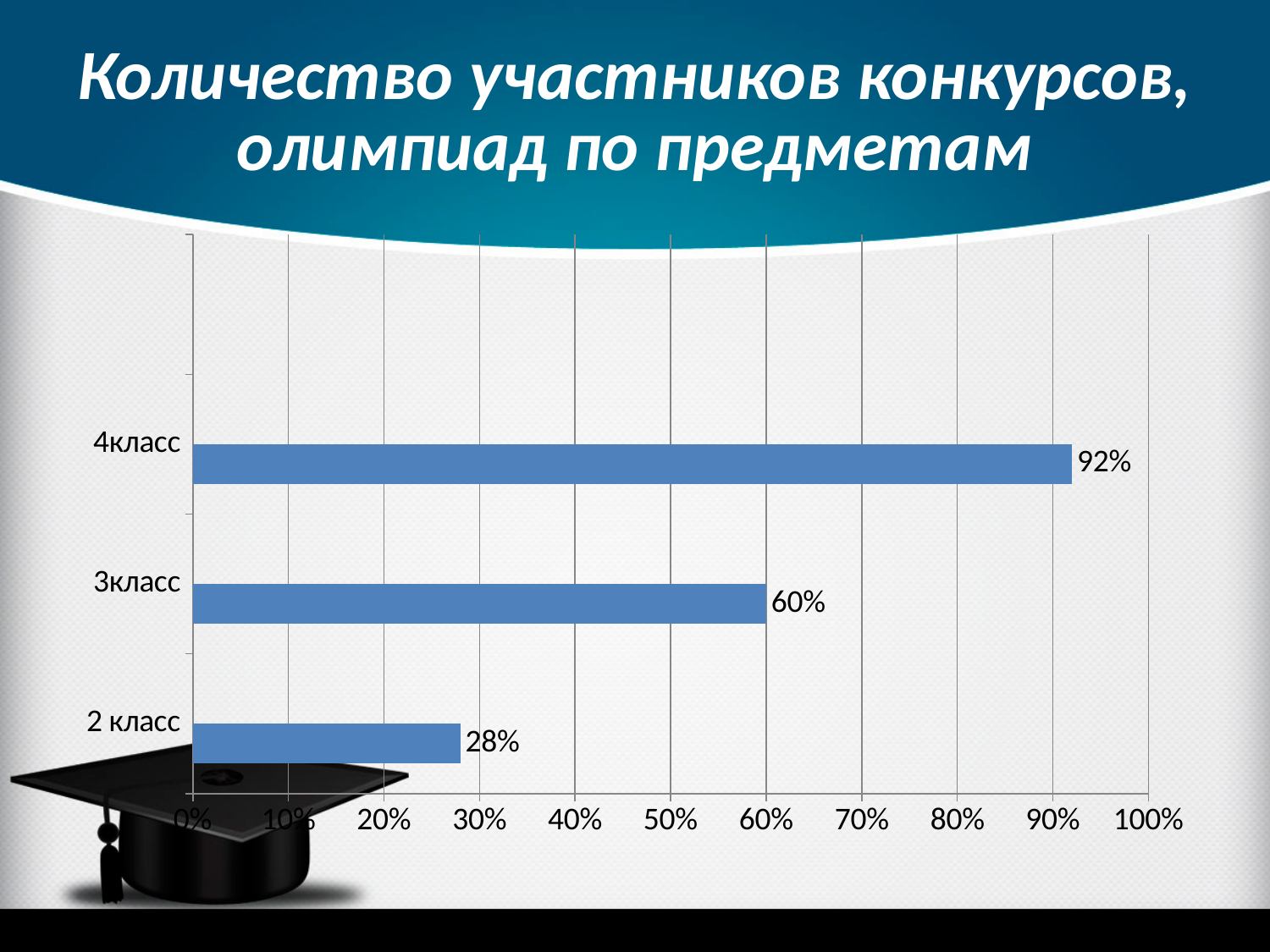
What is the value for 4класс? 92% What is the value for 3класс? 60% How many categories are shown in the chart? 3 Which is larger, the value for 3класс or the value for 2 класс? 3класс Is the value for 4класс greater or less than 90%? greater What kind of chart is shown on the slide? bar chart Which category has the lowest value? 2 класс Which category has the highest value? 4класс What is the difference between the values for 3класс and 2 класс? 32% What is the title of the slide? Количество участников конкурсов, олимпиад по предметам What is the difference between the values for 4класс and 3класс? 32% What is the value for 2 класс? 28%